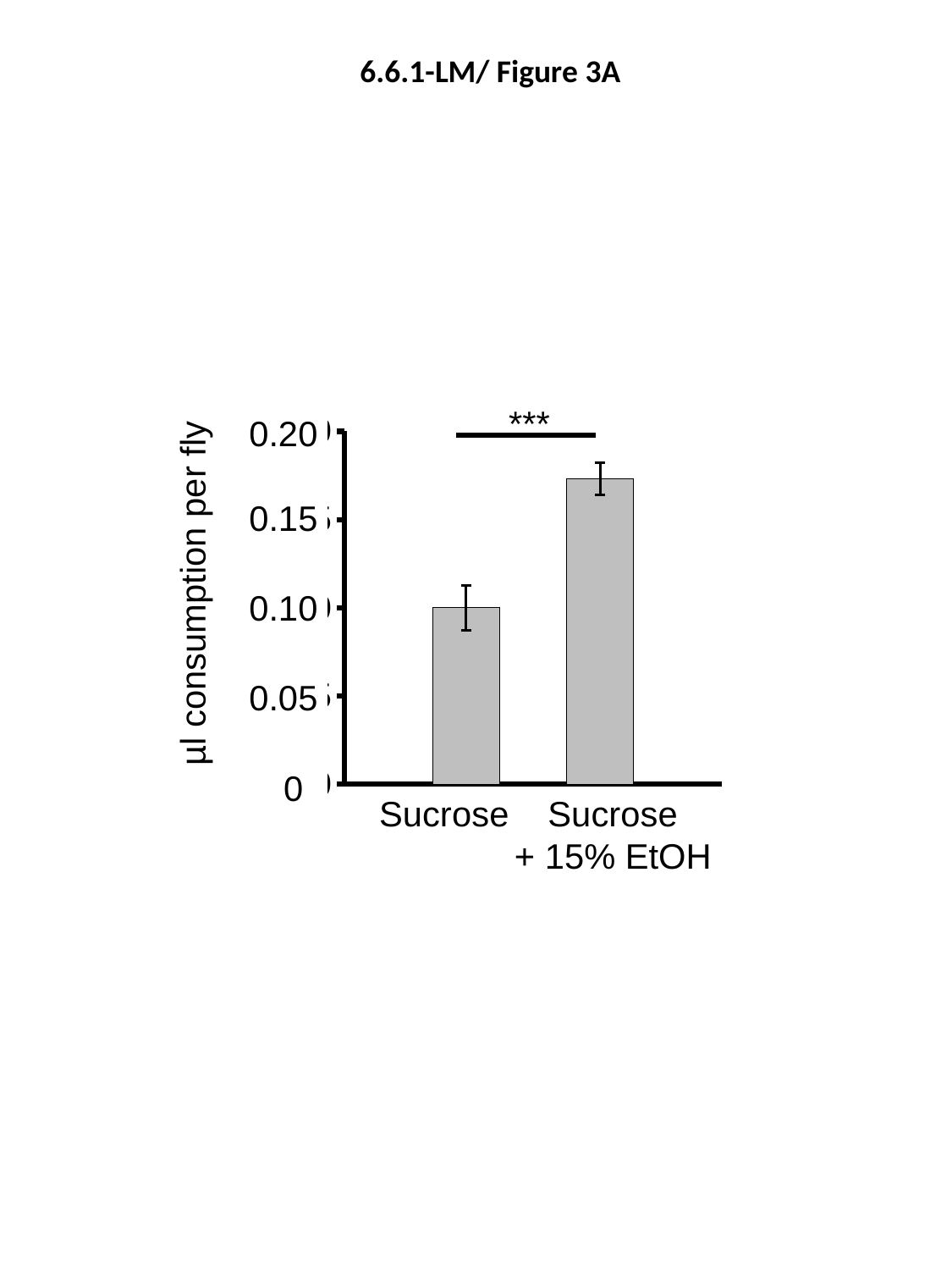
Is the value for Sucrose greater or less than 0.15? less Is the value for Sucrose + 15% EtOH greater or less than 0.15? greater Which category has the lowest µl consumption per fly? Sucrose What is the label of the y axis? µl consumption per fly Which category has the highest µl consumption per fly? Sucrose + 15% EtOH Do the values rise or fall from the Sucrose bar to the Sucrose + 15% EtOH bar? rise What is the title shown at the top of the slide? 6.6.1-LM/ Figure 3A What value does the Sucrose bar reach on the y axis? 0.10 Is the value for Sucrose + 15% EtOH greater or less than 0.20? less What kind of chart is shown on the slide? bar chart How many bars (categories) are plotted in the chart? 2 Which is larger, the value for Sucrose or the value for Sucrose + 15% EtOH? Sucrose + 15% EtOH